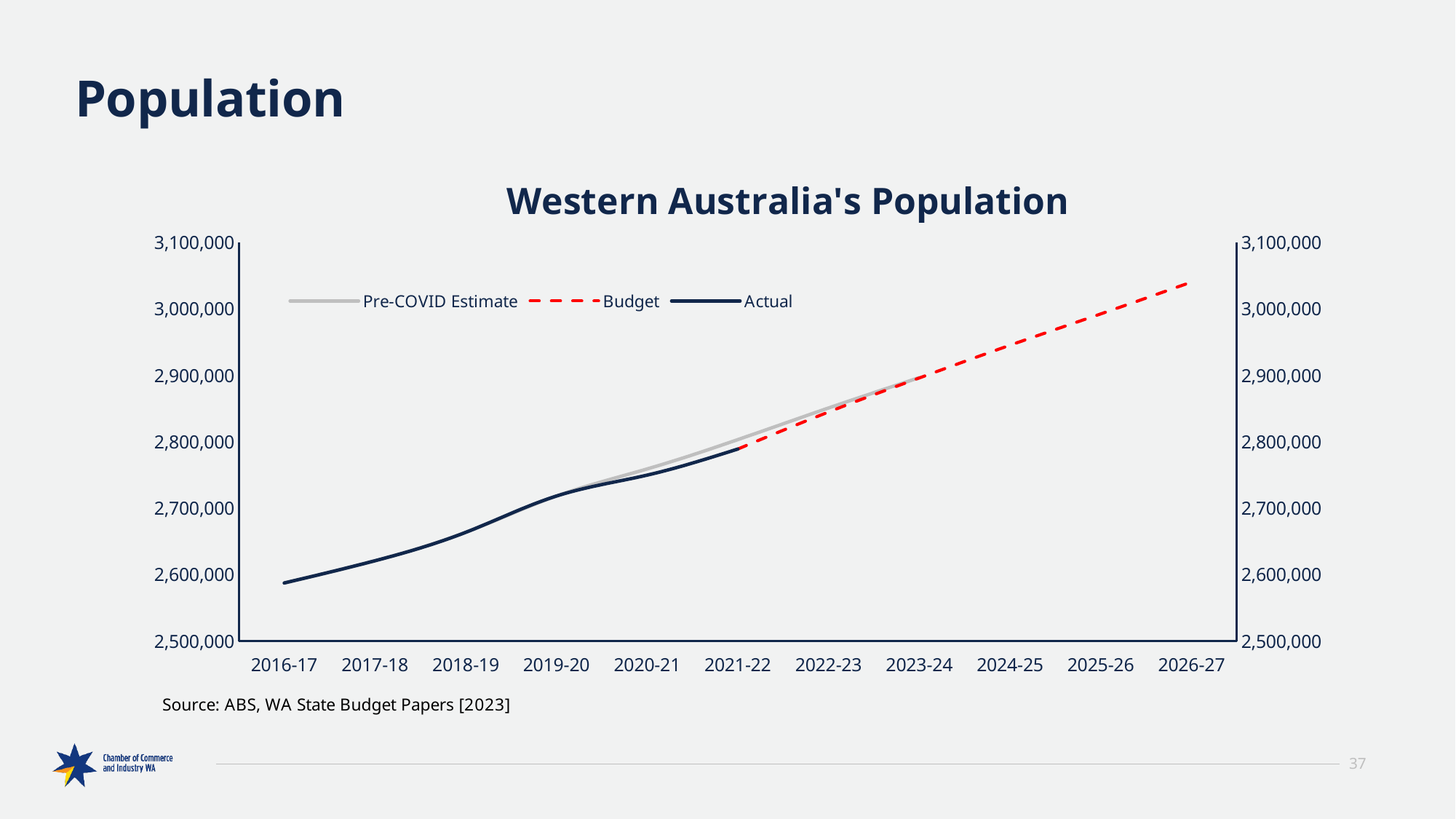
Is the Actual value for 2016-17 greater or less than 2,700,000? less Is the Actual value for 2018-19 greater or less than 2,700,000? less How many series does the legend list? 3 Which series is drawn as a red dashed line? Budget Is the Budget value for 2026-27 greater or less than 3,000,000? greater How many financial years are shown on the x axis? 11 What kind of chart is shown on the slide? line chart Which year has the lowest Actual population value? 2016-17 Does Western Australia's population rise or fall across the years shown? rise What is the title of the chart? Western Australia's Population